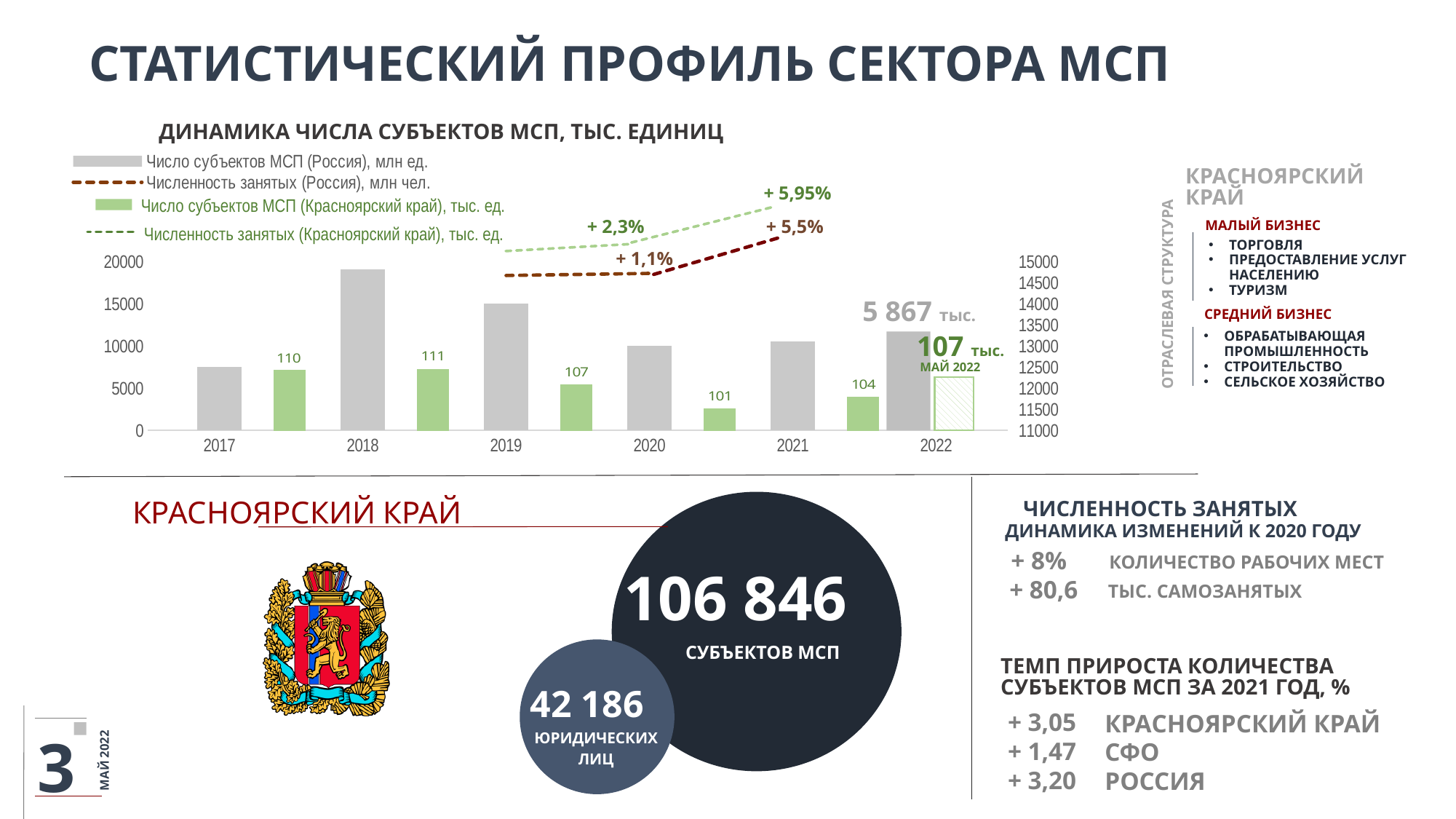
Which year has the larger Число субъектов МСП (Красноярский край) value, 2019 or 2021? 2019 What is the difference between the Число субъектов МСП (Красноярский край) values for 2018 and 2020? 10 How many series does the chart legend list? 4 In which year is the Число субъектов МСП (Красноярский край) value the lowest? 2020 In which year is the Число субъектов МСП (Красноярский край) value the highest? 2018 What is the value of Число субъектов МСП (Красноярский край) for 2020? 101 How many years are shown on the x axis of the chart? 6 What value is labelled on the Число субъектов МСП (Красноярский край) bar for 2022? 107 тыс. Do the Число субъектов МСП (Красноярский край) values rise or fall from 2017 to 2020? fall What value is labelled on the Число субъектов МСП (Россия) bar for 2022? 5 867 тыс. What is the value of Число субъектов МСП (Красноярский край) for 2017? 110